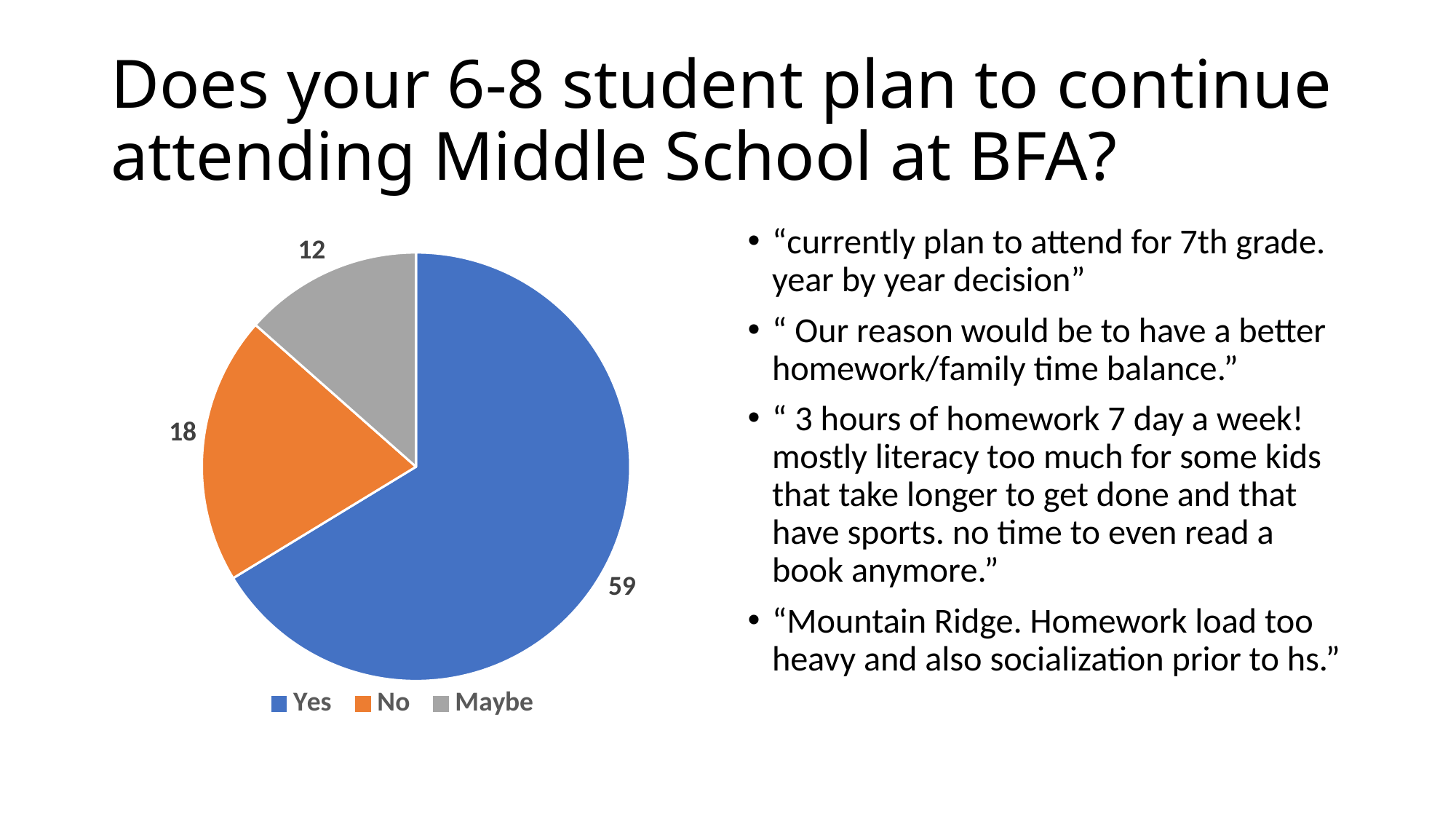
What kind of chart is shown on the slide? pie chart Which category has the largest slice? Yes Which is larger, the value for No or the value for Maybe? No How many categories does the pie chart have? 3 What is the value for Maybe? 12 What is the value for Yes? 59 What is the total of all slices in the pie chart? 89 What is the value for No? 18 What is the difference between the values for No and Maybe? 6 Which colour represents the Maybe category in the legend? grey What is the difference between the values for Yes and No? 41 Which category has the smallest slice? Maybe